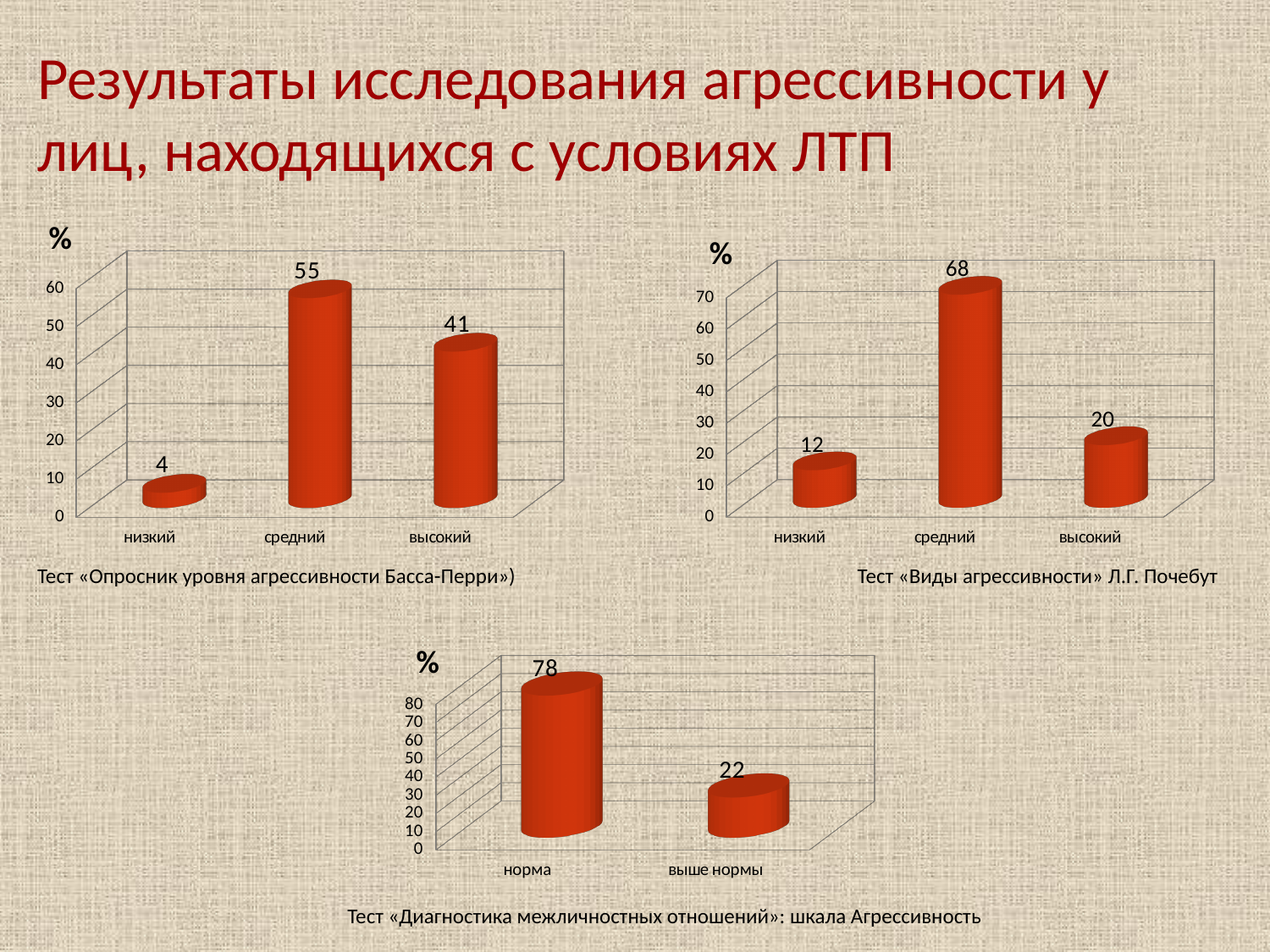
What kind of chart is the bottom chart (Тест «Диагностика межличностных отношений»: шкала Агрессивность)? bar chart In the top-left chart (Тест «Опросник уровня агрессивности Басса-Перри»), what is the value for средний? 55 In the top-right chart (Тест «Виды агрессивности» Л.Г. Почебут), what is the value for высокий? 20 In the bottom chart (Тест «Диагностика межличностных отношений»: шкала Агрессивность), what is the value for норма? 78 In the top-left chart (Тест «Опросник уровня агрессивности Басса-Перри»), which category has the lowest value? низкий In the bottom chart (Тест «Диагностика межличностных отношений»: шкала Агрессивность), how many categories are shown? 2 In the top-right chart (Тест «Виды агрессивности» Л.Г. Почебут), how many categories are shown? 3 In the bottom chart (Тест «Диагностика межличностных отношений»: шкала Агрессивность), what is the difference between the values for норма and выше нормы? 56 In the top-left chart (Тест «Опросник уровня агрессивности Басса-Перри»), what unit is shown on the vertical axis label? % In the top-left chart (Тест «Опросник уровня агрессивности Басса-Перри»), what is the difference between the values for средний and высокий? 14 In the top-right chart (Тест «Виды агрессивности» Л.Г. Почебут), which category has the highest value? средний In the top-right chart (Тест «Виды агрессивности» Л.Г. Почебут), which is larger, the value for низкий or the value for высокий? высокий